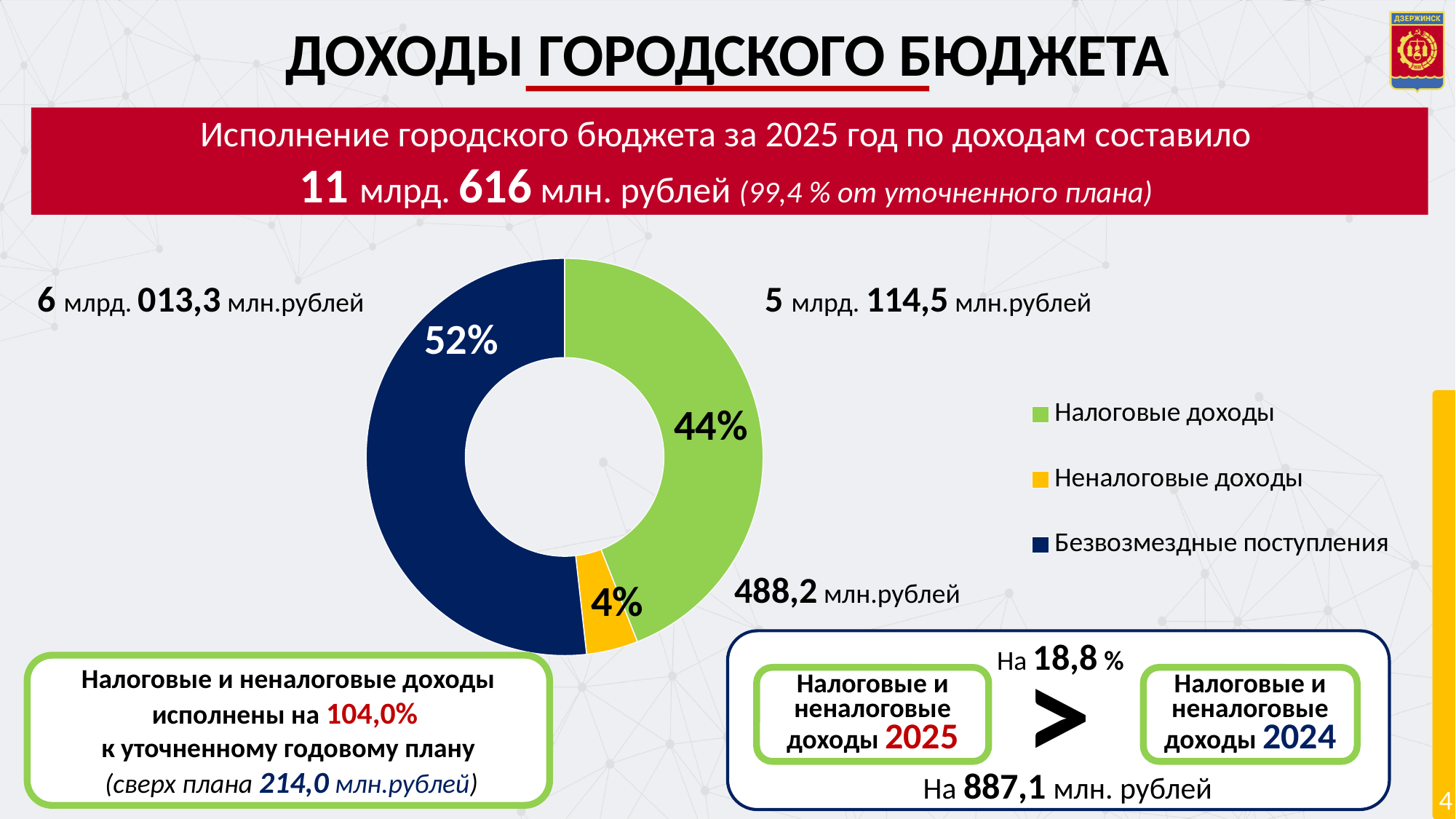
What kind of chart is shown on the slide? Pie chart (donut) What is the difference in percentage points between the Безвозмездные поступления slice and the Налоговые доходы slice? 8 Which is larger, the share for Налоговые доходы or the share for Безвозмездные поступления? Безвозмездные поступления What colour is the slice for Неналоговые доходы? Yellow How many categories does the pie chart show? 3 What share of the pie does Неналоговые доходы represent? 4% How many entries does the legend list? 3 Which category has the largest slice of the pie? Безвозмездные поступления What colour is the slice for Безвозмездные поступления? Dark blue What share of the pie does Налоговые доходы represent? 44% What share of the pie does Безвозмездные поступления represent? 52% Which category has the smallest slice of the pie? Неналоговые доходы